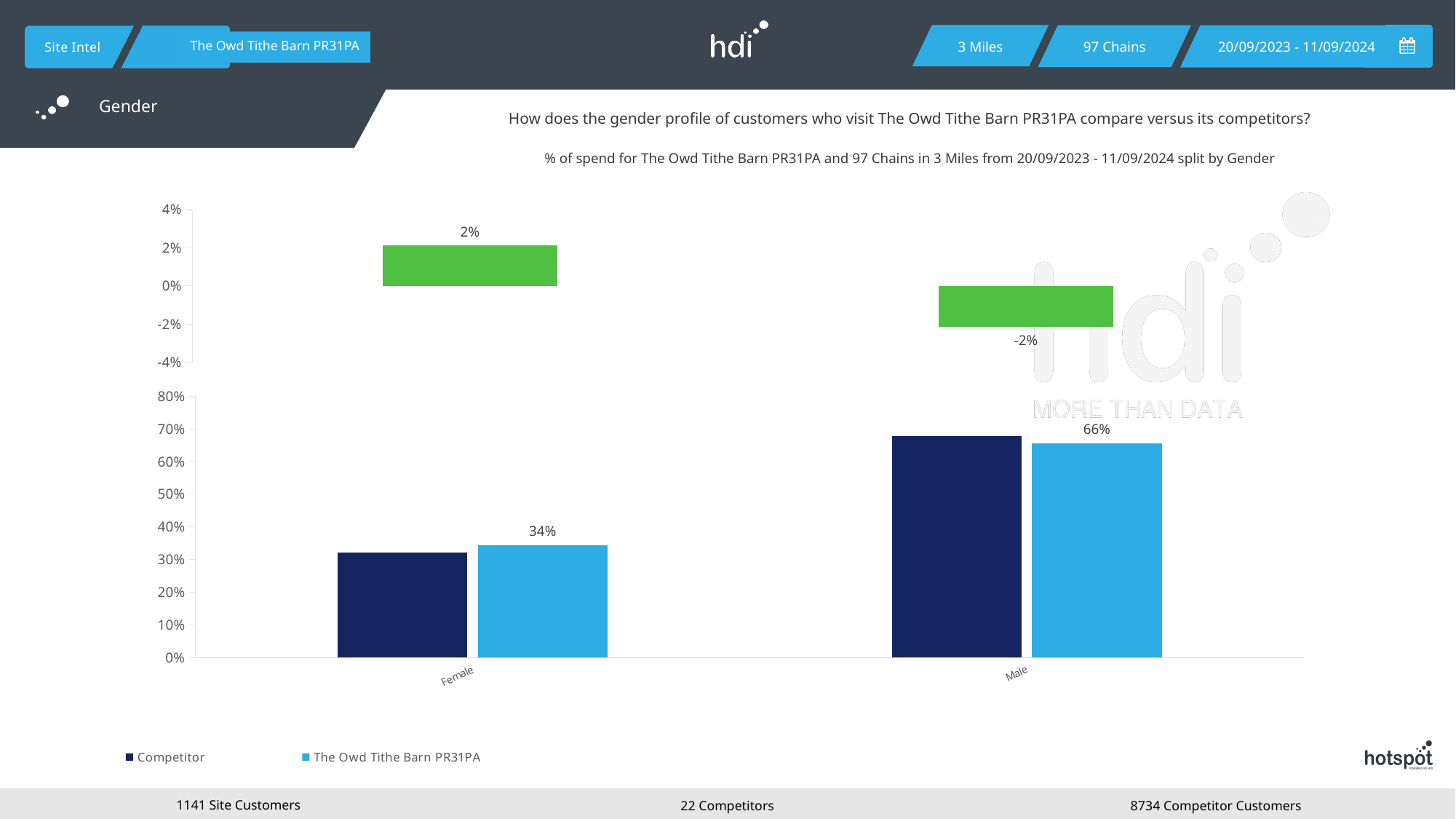
In the bottom chart, what is the value for The Owd Tithe Barn PR31PA for Female? 34% In the bottom chart, which category has the higher value for The Owd Tithe Barn PR31PA, Female or Male? Male How many categories are shown on the x axis of the bottom chart? 2 In the bottom chart, is the Competitor value for Male greater or less than 60%? greater In the bottom chart, is the Competitor value for Female greater or less than 40%? less In the top chart, what is the value shown for Female? 2% What kind of chart is the bottom chart? Bar chart In the bottom chart, what is the value for The Owd Tithe Barn PR31PA for Male? 66% In the bottom chart, what is the difference between The Owd Tithe Barn PR31PA's Male and Female values? 32% How many series does the legend of the bottom chart list? 2 In the top chart, what is the value shown for Male? -2% In the bottom chart, which is larger for Female: the Competitor value or The Owd Tithe Barn PR31PA value? The Owd Tithe Barn PR31PA